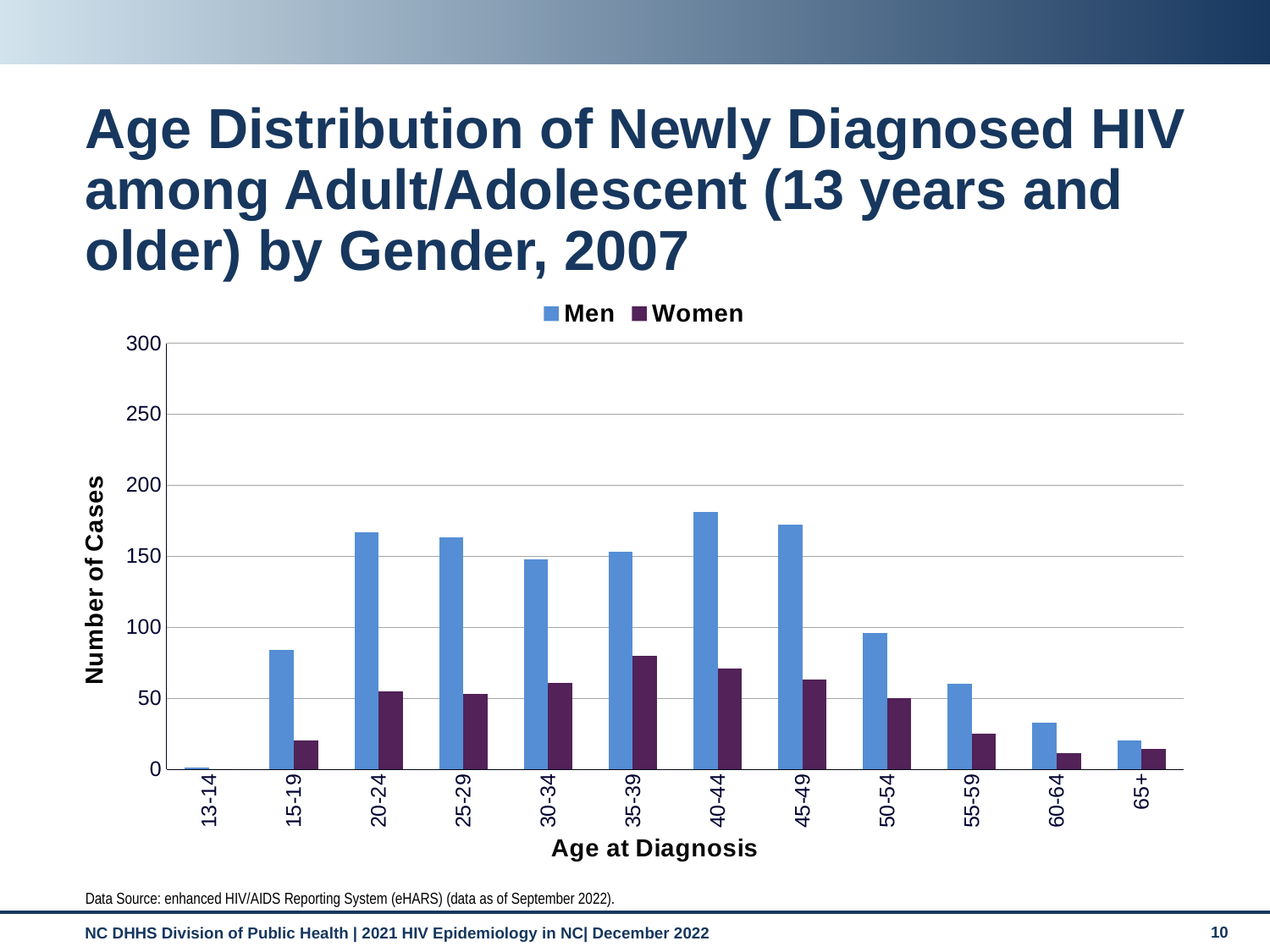
In the 30-34 age group, which series has more cases, Men or Women? Men Is the value for Women in the 60-64 age group greater or less than 50? less Do the values for Men rise or fall from the 45-49 age group to the 65+ age group? fall Is the value for Women in the 35-39 age group greater or less than 50? greater What is the title of the y axis? Number of Cases How many age groups are shown on the x axis? 12 What kind of chart is shown on the slide? bar chart How many series does the legend list? 2 Which age group has the highest number of cases for Women? 35-39 Is the value for Men in the 40-44 age group greater or less than 150? greater Which age group has the lowest number of cases for Men? 13-14